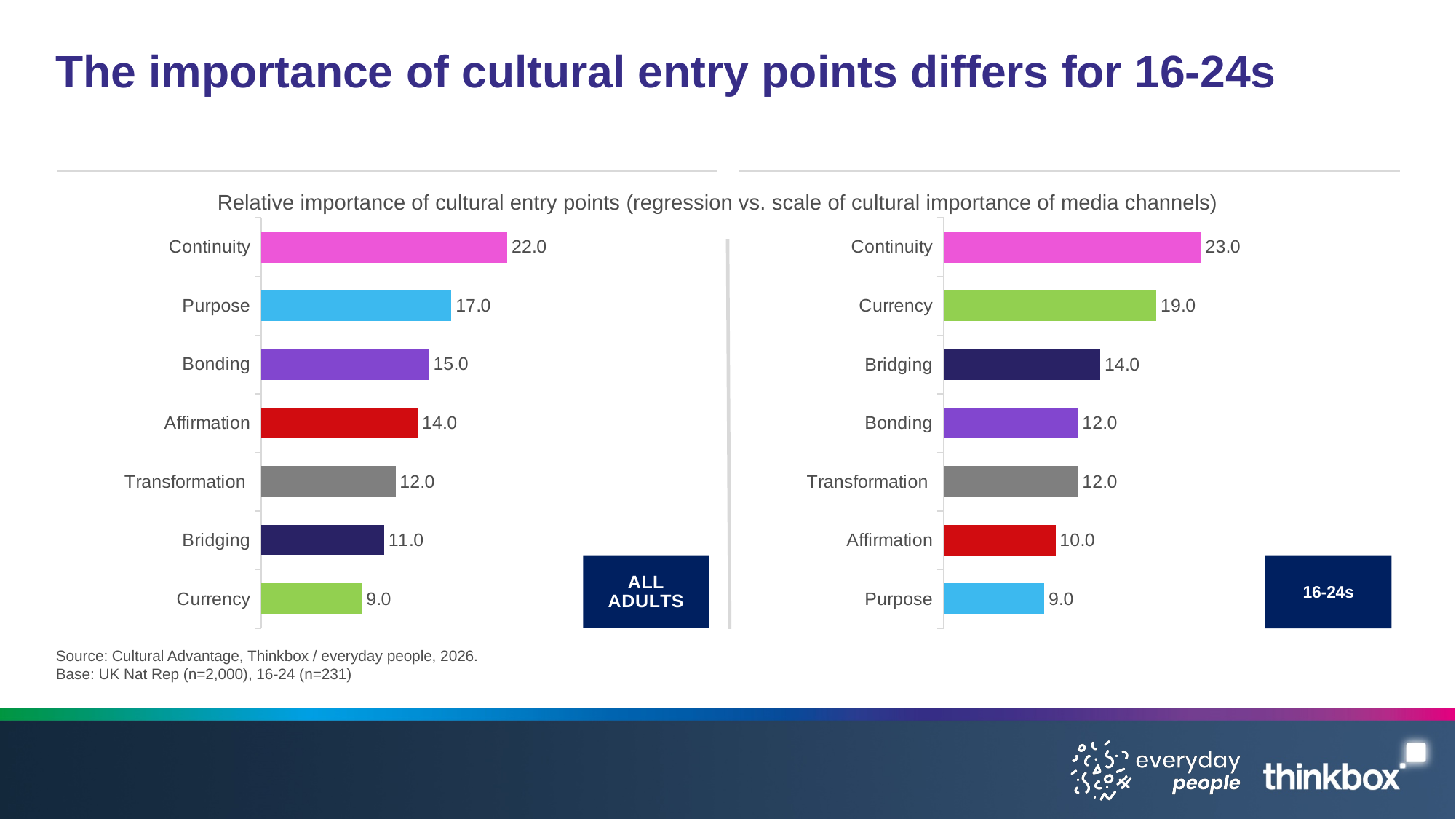
In the 16-24s chart, what is the value for Currency? 19.0 In the 16-24s chart, what is the value for Affirmation? 10.0 In the ALL ADULTS chart, which is larger, Bonding or Affirmation? Bonding In the 16-24s chart, what is the difference between Continuity and Bridging? 9.0 What is the title shown above the two charts? Relative importance of cultural entry points (regression vs. scale of cultural importance of media channels) Which is larger: Bridging in the ALL ADULTS chart or Bridging in the 16-24s chart? 16-24s In the ALL ADULTS chart, what is the value for Purpose? 17.0 In the ALL ADULTS chart, what is the difference between Continuity and Currency? 13.0 In the ALL ADULTS chart, which category has the highest value? Continuity How many categories are shown in the 16-24s chart? 7 What type of chart is the ALL ADULTS chart? Bar chart In the 16-24s chart, which category has the lowest value? Purpose